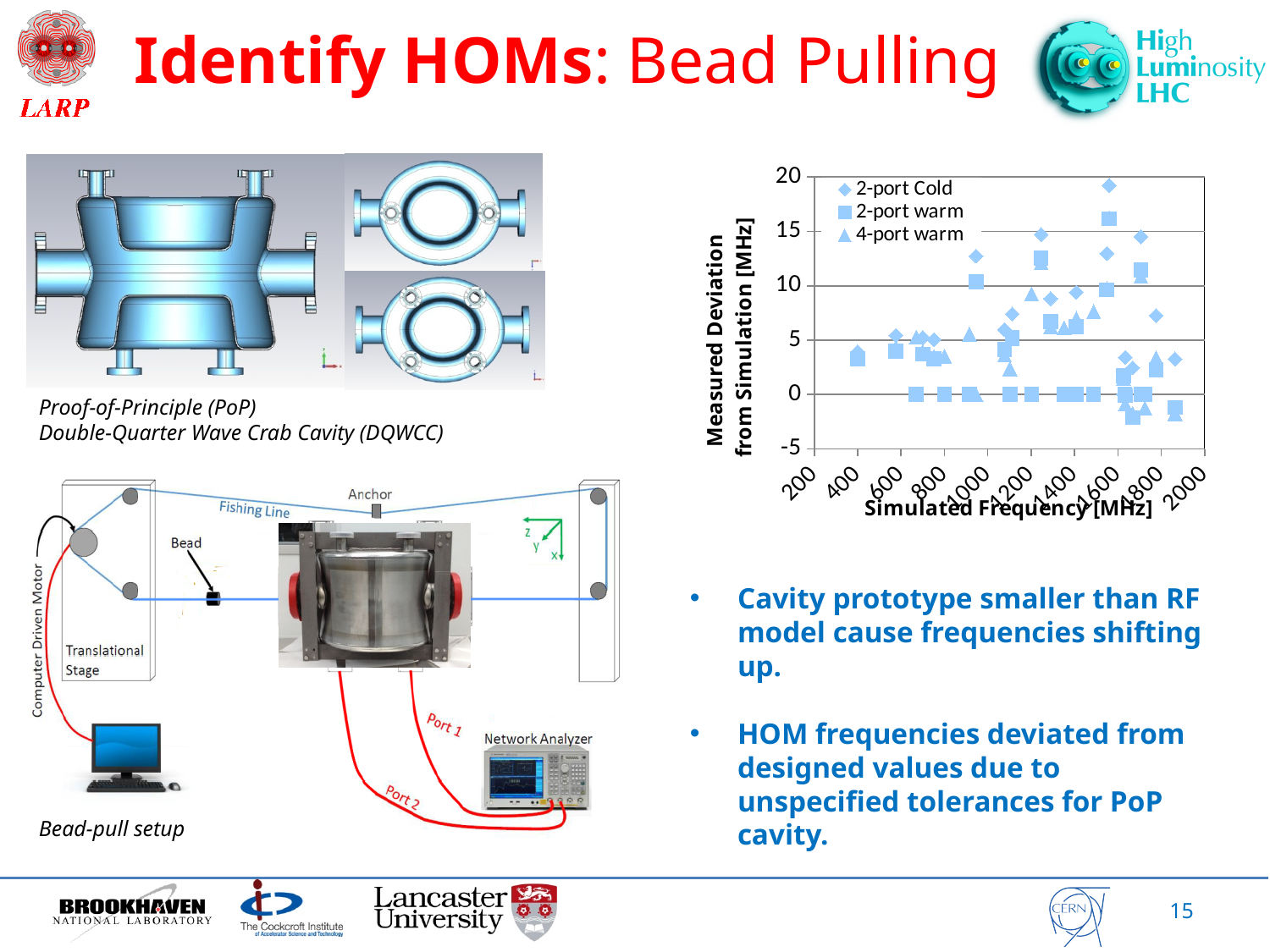
What is the lowest value shown on the y axis of the scatter chart? -5 Is the highest 4-port warm point on the scatter chart greater or less than 10 MHz? greater Is the highest 2-port Cold point on the scatter chart greater or less than 15 MHz? greater What is the label of the x axis of the scatter chart? Simulated Frequency [MHz] Is the lowest point on the scatter chart greater or less than 0 MHz? less What kind of chart is shown on the right side of the slide? Scatter chart Which series on the scatter chart contains the single highest measured deviation? 2-port Cold What is the highest value shown on the y axis of the scatter chart? 20 What is the highest value shown on the x axis of the scatter chart? 2000 What are the three series named in the legend of the scatter chart? 2-port Cold, 2-port warm, 4-port warm How many series does the legend of the scatter chart list? 3